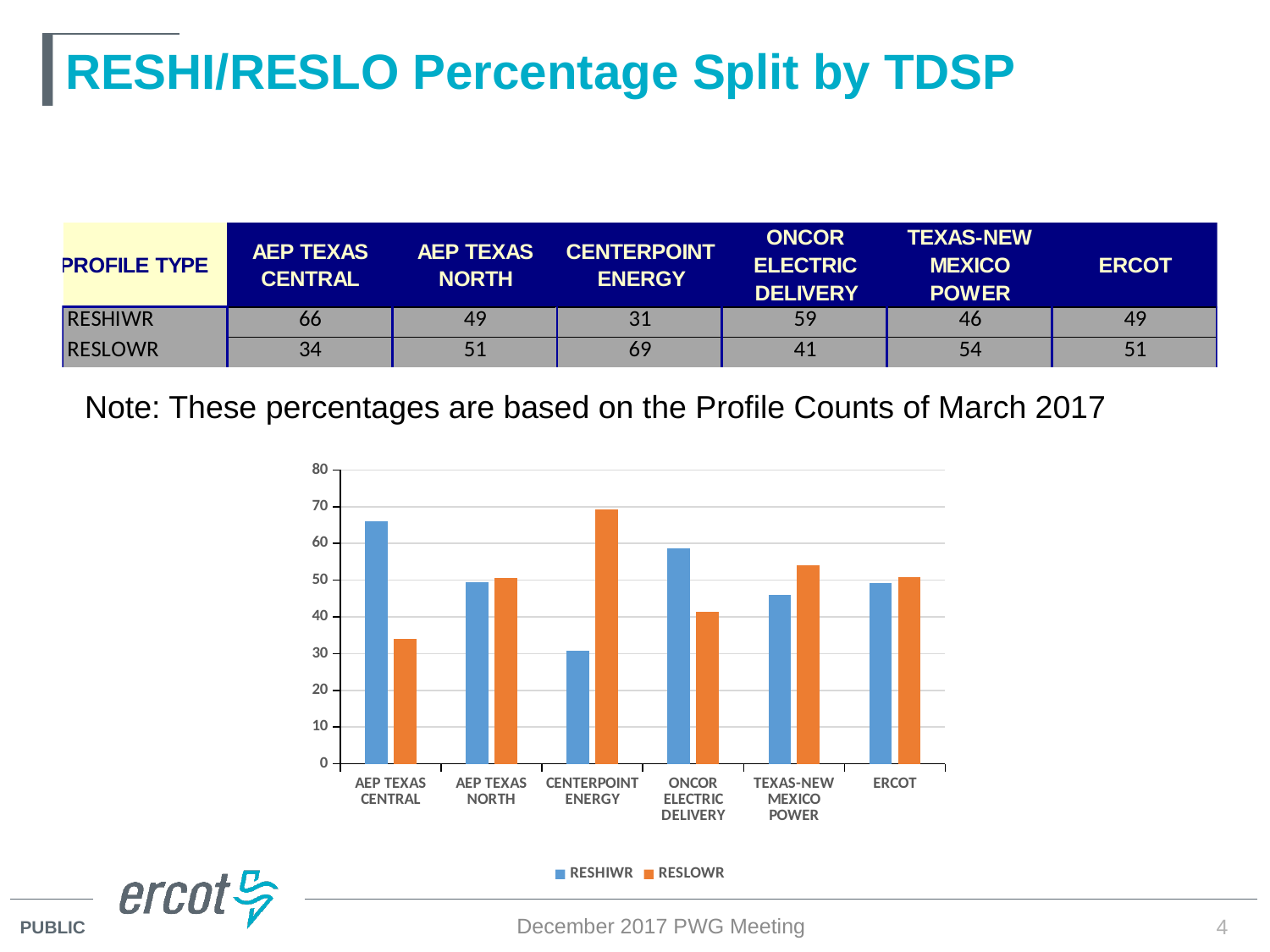
Which series is shown in orange in the chart? RESLOWR What is the difference between the RESHIWR and RESLOWR values for ONCOR ELECTRIC DELIVERY? 18 Which category has the lowest RESLOWR value? AEP TEXAS CENTRAL How many TDSP categories are shown on the x axis of the chart? 6 Is the RESHIWR value for ONCOR ELECTRIC DELIVERY greater or less than 50? greater What is the RESHIWR value for AEP TEXAS CENTRAL? 66 What is the RESLOWR value for CENTERPOINT ENERGY? 69 Which category has the lowest RESHIWR value? CENTERPOINT ENERGY What type of chart is shown on the slide? bar chart For TEXAS-NEW MEXICO POWER, which is larger, RESHIWR or RESLOWR? RESLOWR How many series does the chart legend list? 2 Which category has the highest RESHIWR value? AEP TEXAS CENTRAL